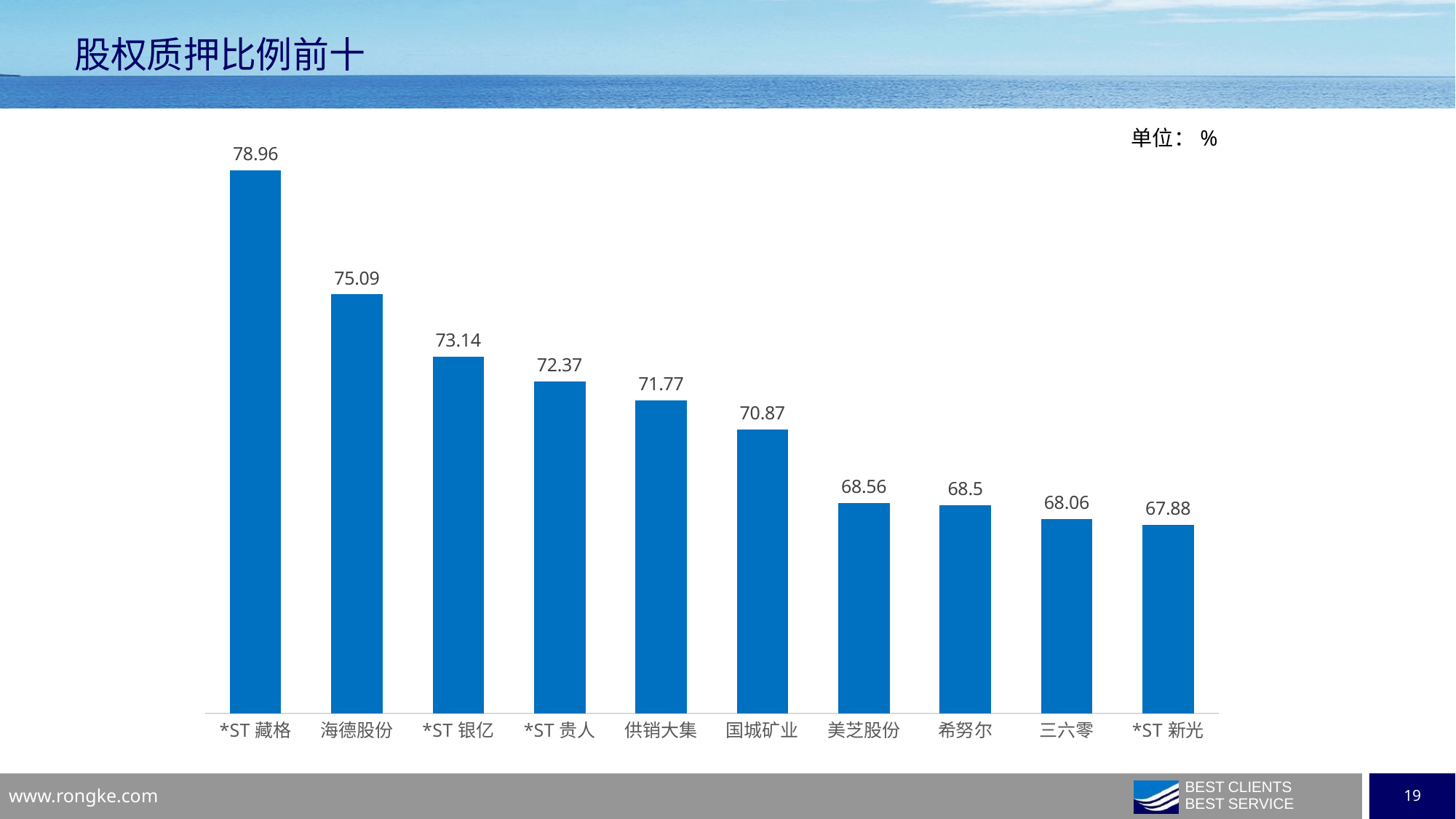
What is the value for *ST 藏格? 78.96 What is the difference between the values for *ST 藏格 and 海德股份? 3.87 Which category has the lowest value? *ST 新光 What is the difference between the values for *ST 银亿 and *ST 新光? 5.26 What is the value for 三六零? 68.06 What unit is indicated for the values in the chart? % What is the value for 海德股份? 75.09 What kind of chart is shown on the slide? Bar chart What is the value for 国城矿业? 70.87 Which category has the highest value? *ST 藏格 How many categories are shown in the chart? 10 Which is larger, the value for 供销大集 or the value for 美芝股份? 供销大集